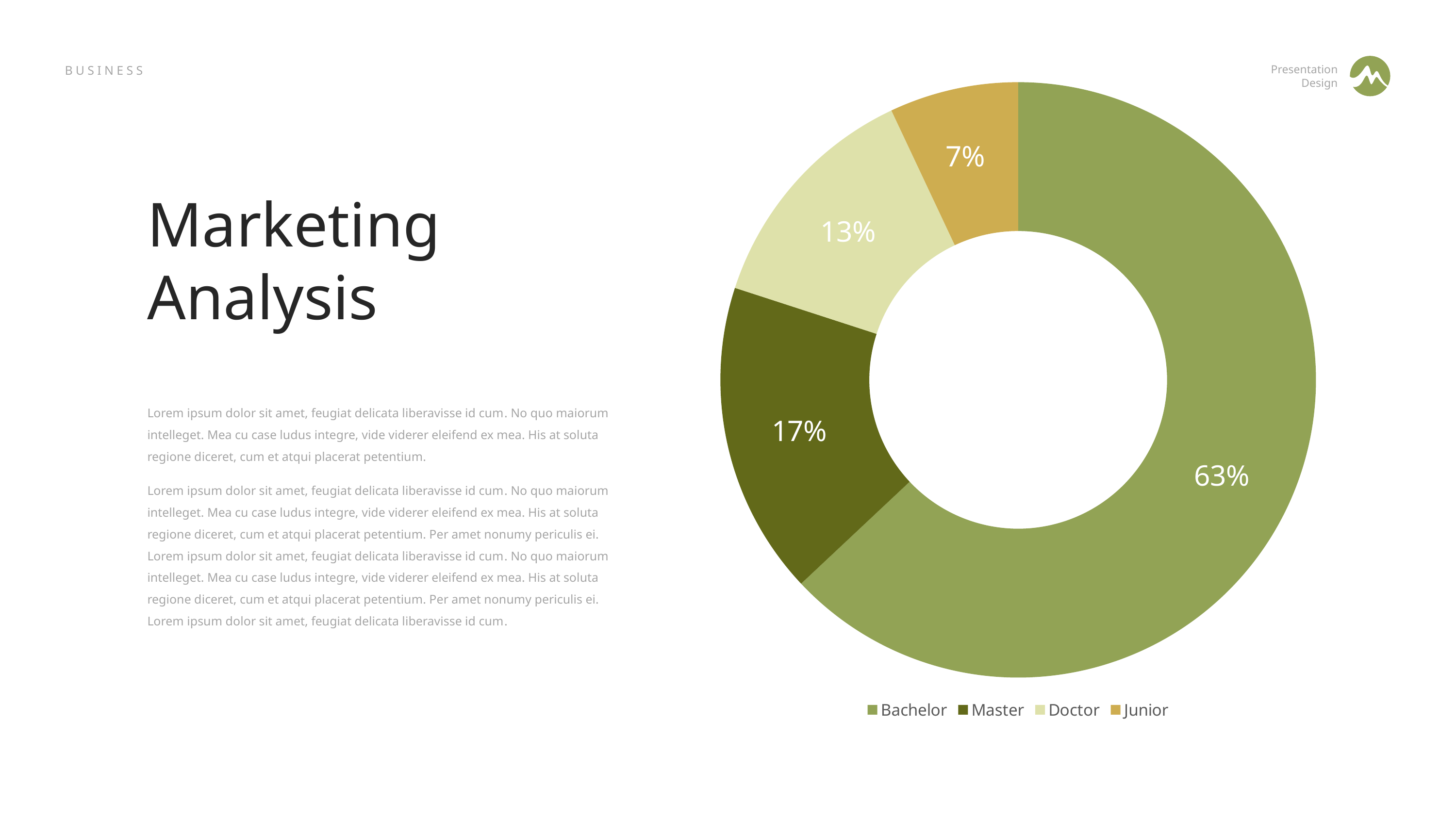
What kind of chart is shown on the slide? Doughnut chart Which category is shown in the orange/gold colour in the legend? Junior Which has a larger share, Master or Doctor? Master What percentage is shown for Master in the chart? 17% Which category has the largest share of the chart? Bachelor Which category has the smallest share of the chart? Junior What is the difference in percentage points between Doctor and Junior? 6 What percentage is shown for Junior in the chart? 7% What percentage is shown for Doctor in the chart? 13% What is the difference in percentage points between Bachelor and Master? 46 How many categories are shown in the chart? 4 What percentage of the doughnut chart does Bachelor account for? 63%